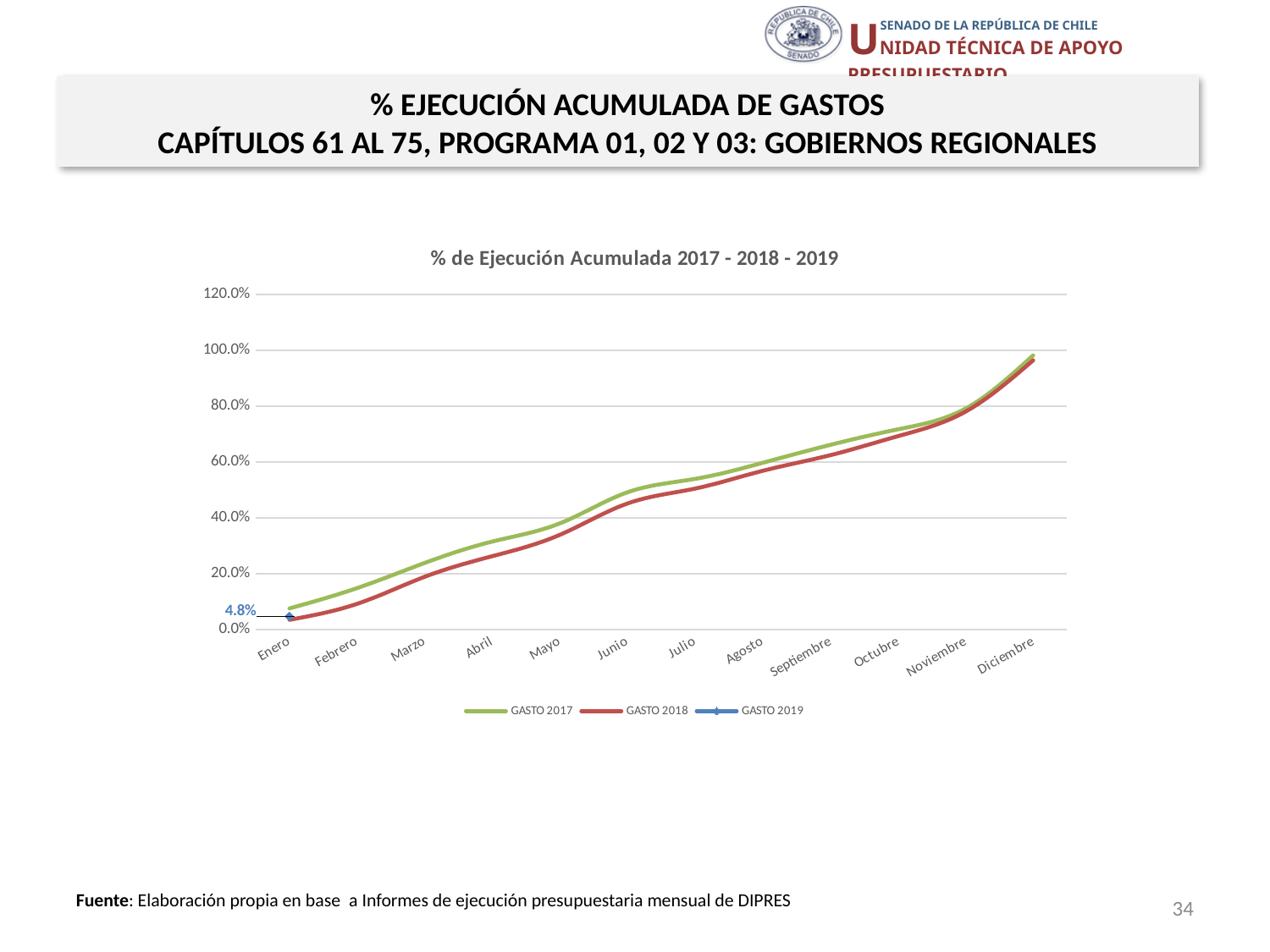
Does the GASTO 2017 line rise or fall from Enero to Diciembre? rise Is the value for GASTO 2018 in Junio greater or less than 60%? less In which month does GASTO 2017 reach its highest value? Diciembre In which month is the GASTO 2018 value lowest? Enero Is the value for GASTO 2017 in Octubre greater or less than 60%? greater What is the value of GASTO 2019 in Enero? 4.8% What is the title of the chart? % de Ejecución Acumulada 2017 - 2018 - 2019 What type of chart is shown on the slide? line chart How many months are shown along the x axis? 12 In Marzo, which series has the higher value, GASTO 2017 or GASTO 2018? GASTO 2017 How many series does the chart legend list? 3 Is the value for GASTO 2017 in Diciembre greater or less than 80%? greater